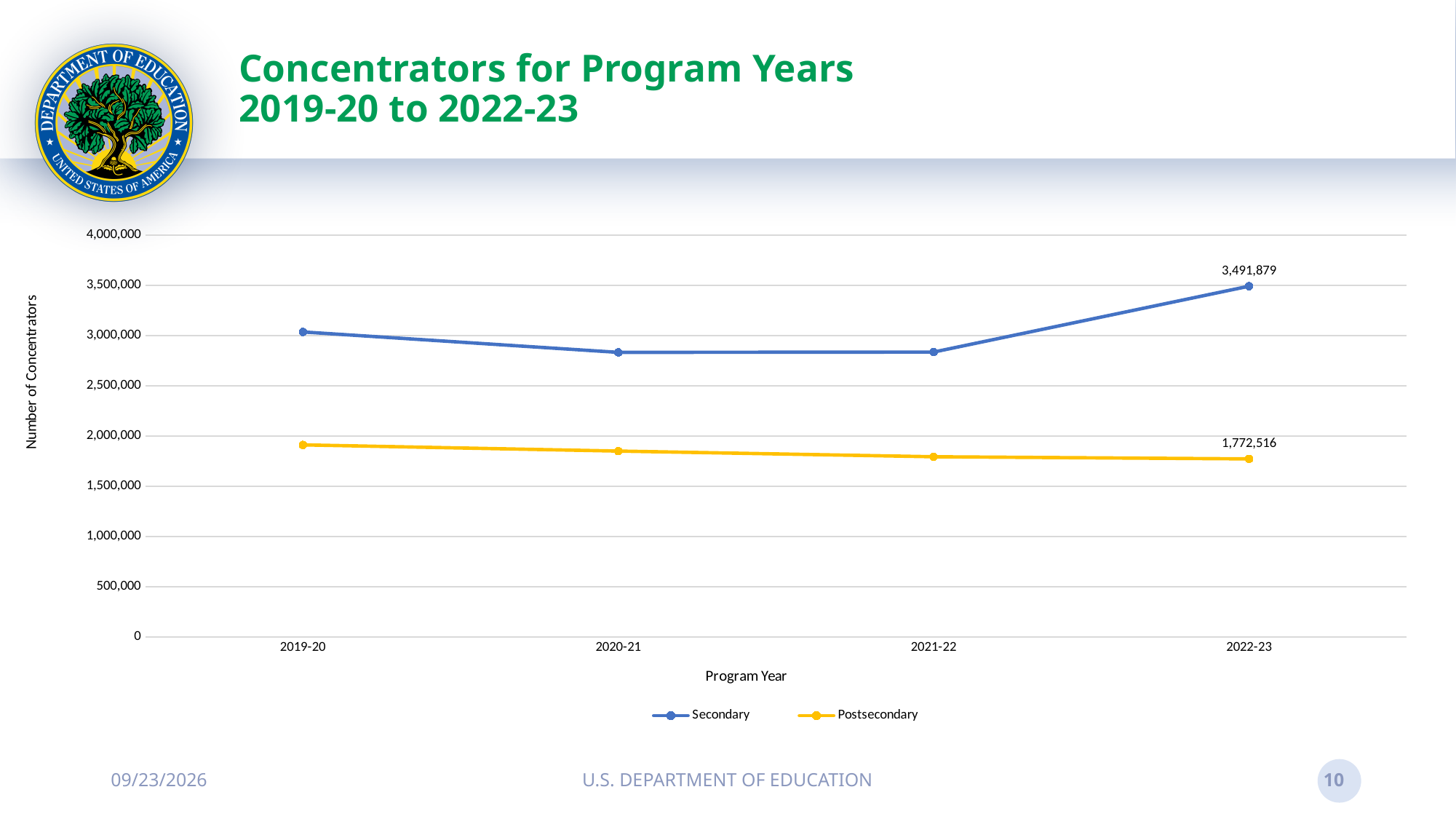
What is the value for Secondary in 2022-23? 3,491,879 Is the Postsecondary value for 2019-20 greater or less than 2,000,000? less How many series does the legend list? 2 How many program years are plotted on the x axis? 4 What is the value for Postsecondary in 2022-23? 1,772,516 Does the Postsecondary series rise or fall from 2019-20 to 2022-23? fall Which program year has the highest Secondary value? 2022-23 Which series is larger in 2021-22, Secondary or Postsecondary? Secondary What type of chart is shown on the slide? line chart Which program year has the lowest Postsecondary value? 2022-23 What is the difference between the Secondary and Postsecondary values in 2022-23? 1,719,363